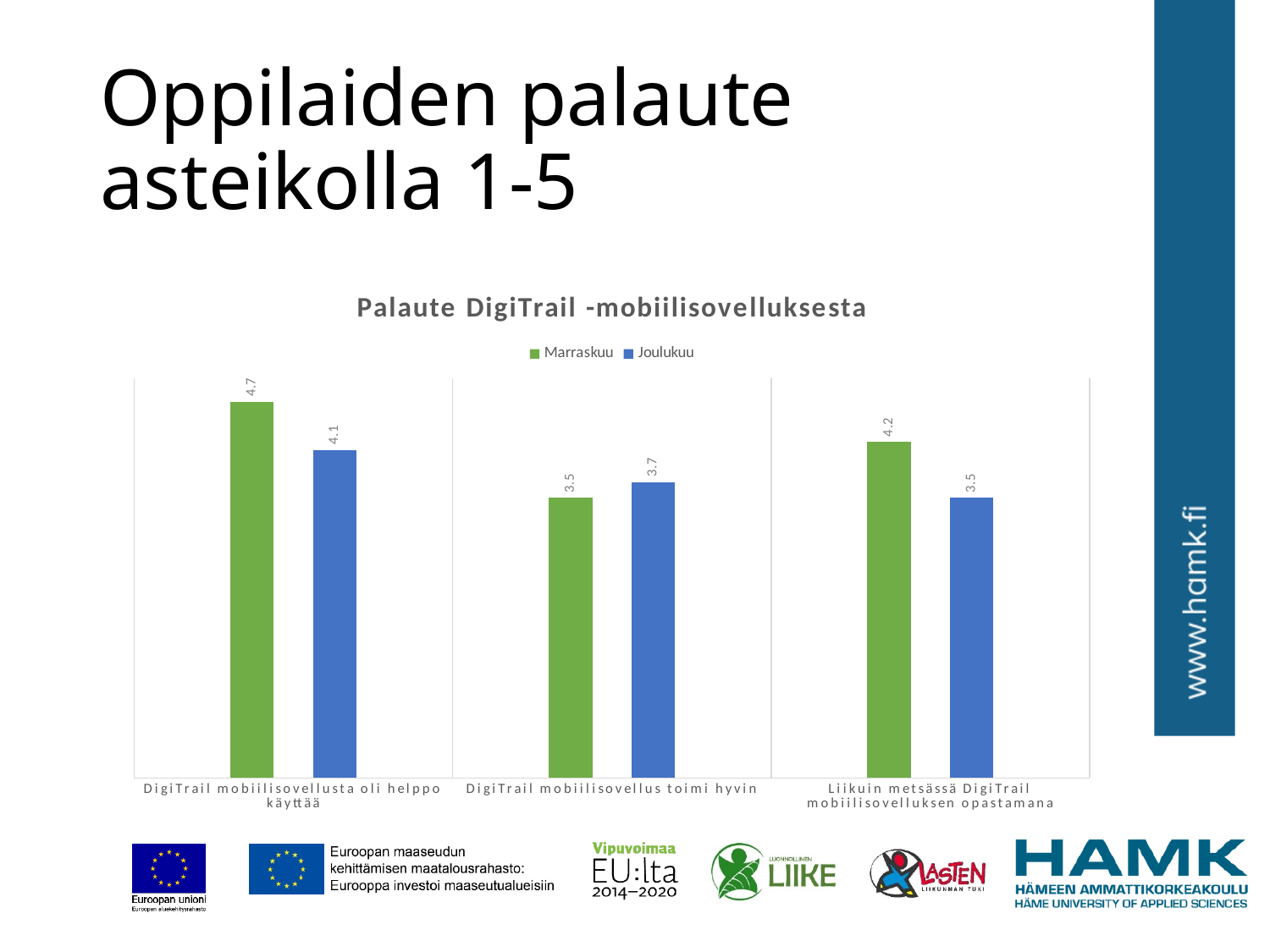
What kind of chart is shown on the slide? Bar chart For "DigiTrail mobiilisovellus toimi hyvin", which series has the larger value, Marraskuu or Joulukuu? Joulukuu What is the Marraskuu value for "Liikuin metsässä DigiTrail mobiilisovelluksen opastamana"? 4.2 Which category has the highest Marraskuu value? DigiTrail mobiilisovellusta oli helppo käyttää Which category has the lowest Joulukuu value? Liikuin metsässä DigiTrail mobiilisovelluksen opastamana How many categories are shown on the x axis of the chart? 3 What is the title of the chart? Palaute DigiTrail -mobiilisovelluksesta How many series does the legend list? 2 What is the Joulukuu value for "Liikuin metsässä DigiTrail mobiilisovelluksen opastamana"? 3.5 What is the Joulukuu value for "DigiTrail mobiilisovellus toimi hyvin"? 3.7 What is the difference between the Marraskuu and Joulukuu values for "DigiTrail mobiilisovellusta oli helppo käyttää"? 0.6 What is the Marraskuu value for "DigiTrail mobiilisovellusta oli helppo käyttää"? 4.7